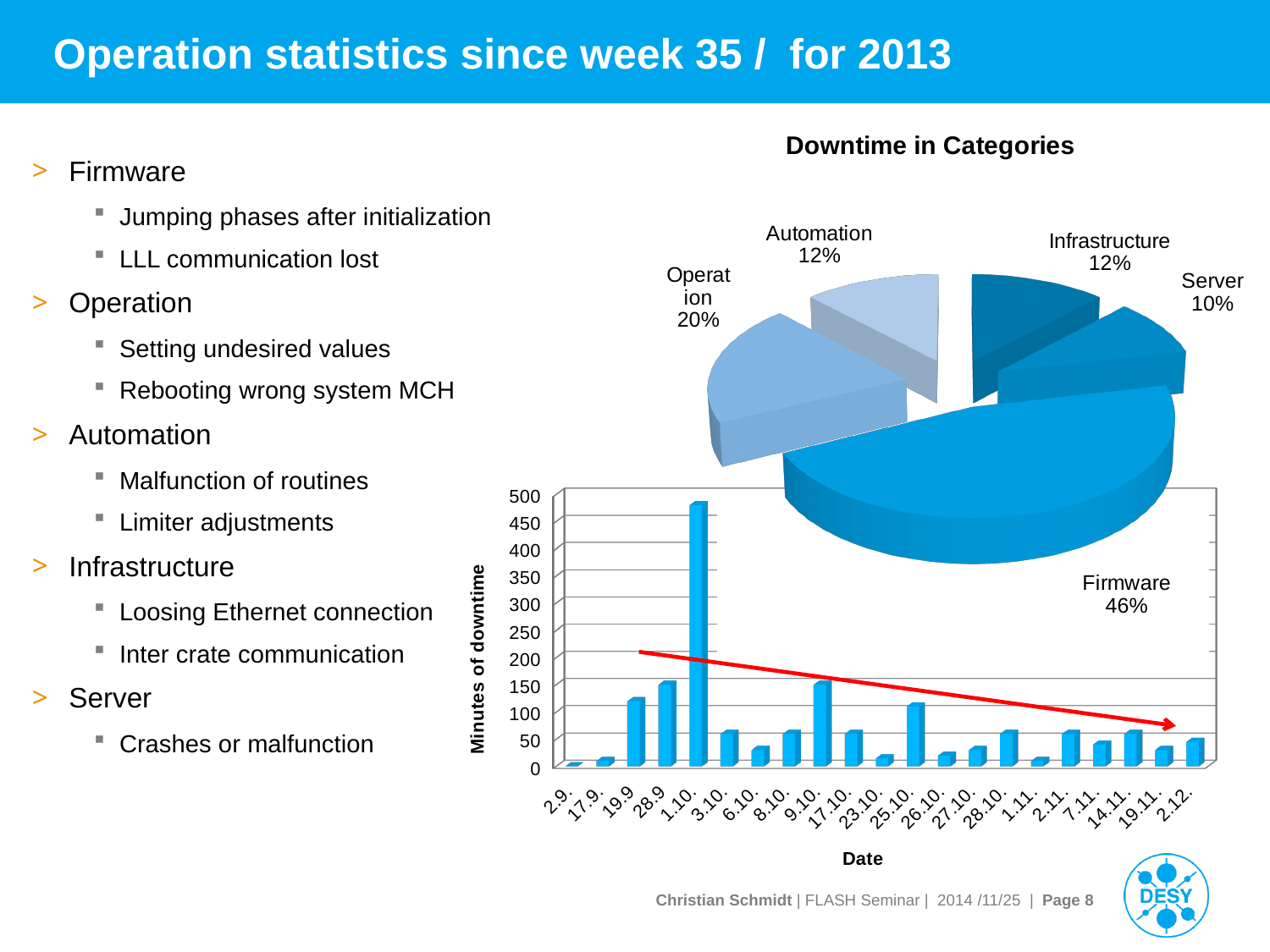
In the pie chart 'Downtime in Categories', what share of downtime is attributed to Operation? 20% In the bar chart of minutes of downtime by date, is the value for 2.9. greater or less than 50? less In the pie chart 'Downtime in Categories', which category has the largest share of downtime? Firmware In the pie chart 'Downtime in Categories', how many categories are shown? 5 In the pie chart 'Downtime in Categories', what share of downtime is attributed to Server? 10% In the pie chart 'Downtime in Categories', how many percentage points larger is the Firmware share than the Operation share? 26 In the bar chart of minutes of downtime by date, what is the title of the vertical axis? Minutes of downtime What kind of chart is the lower chart showing minutes of downtime by date? Bar chart In the pie chart 'Downtime in Categories', which category has the smallest share of downtime? Server In the pie chart 'Downtime in Categories', what share of downtime is attributed to Firmware? 46% In the bar chart of minutes of downtime by date, which date has the highest downtime? 1.10. In the bar chart of minutes of downtime by date, is the value for 1.10. greater or less than 400? greater